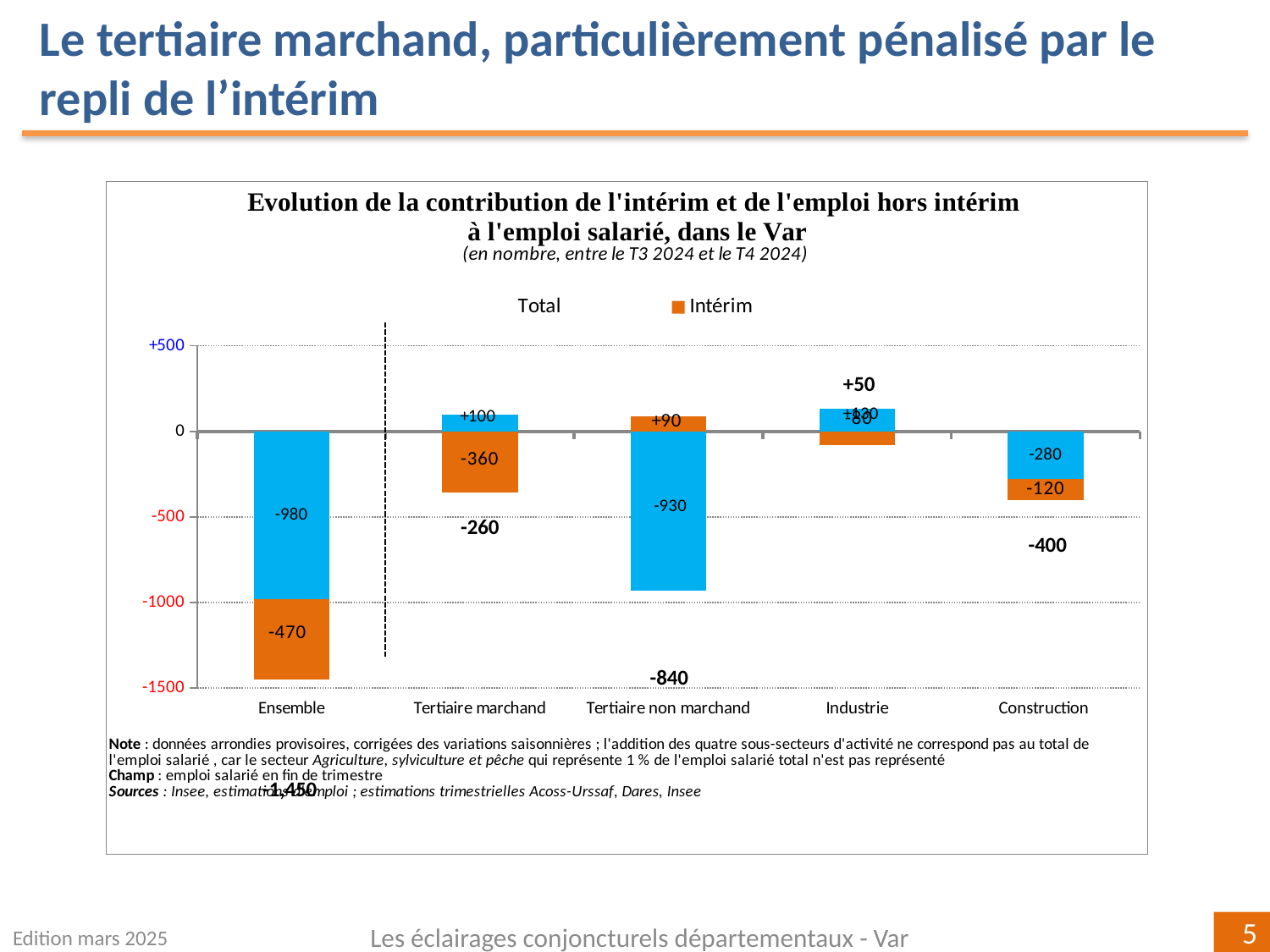
Among the four sectors (excluding Ensemble), which has the lowest Total value? Tertiaire non marchand What is the difference between the Intérim values for Tertiaire marchand (-360) and Construction (-120)? 240 What kind of chart is this? Bar chart What is the Intérim value for Tertiaire marchand? -360 Which is larger, the Intérim value for Tertiaire marchand or for Tertiaire non marchand? Tertiaire non marchand What is the Total value shown for Tertiaire non marchand? -840 Which entries does the legend list? Total and Intérim What is the Intérim value for Construction? -120 How many categories are shown on the x axis? 5 What is the Total value shown for Industrie? +50 What is the Intérim value for Ensemble? -470 What is the Total value shown for Construction? -400